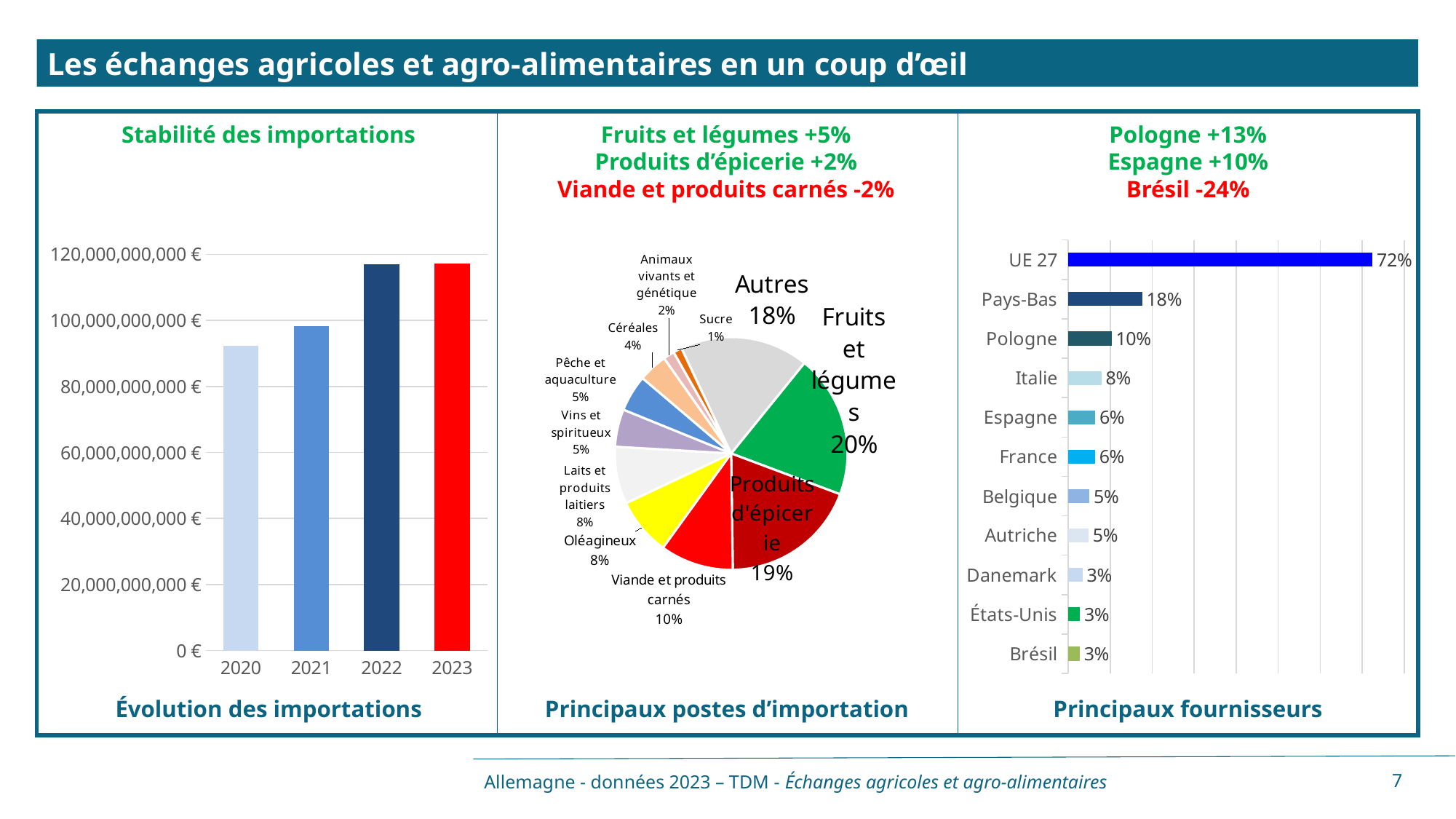
In the 'Évolution des importations' chart, which year has the lowest value? 2020 How many years are shown in the 'Évolution des importations' chart? 4 In the 'Évolution des importations' chart, is the value for 2020 greater or less than 100,000,000,000 €? less In the 'Principaux fournisseurs' chart, which category has the highest value? UE 27 In the 'Principaux postes d'importation' pie chart, which slice is the smallest? Sucre In the 'Évolution des importations' chart, is the value for 2022 greater or less than 100,000,000,000 €? greater In the 'Principaux fournisseurs' chart, what is the difference between Pays-Bas and Pologne? 8% In the 'Principaux postes d'importation' pie chart, what is the difference between 'Fruits et légumes' and 'Viande et produits carnés'? 10% In the 'Évolution des importations' chart, do the values rise or fall from 2020 to 2023? rise In the 'Principaux postes d'importation' pie chart, what share does 'Viande et produits carnés' have? 10% In the 'Principaux fournisseurs' chart, what is the value for Pologne? 10% What kind of chart is 'Principaux postes d'importation'? pie chart